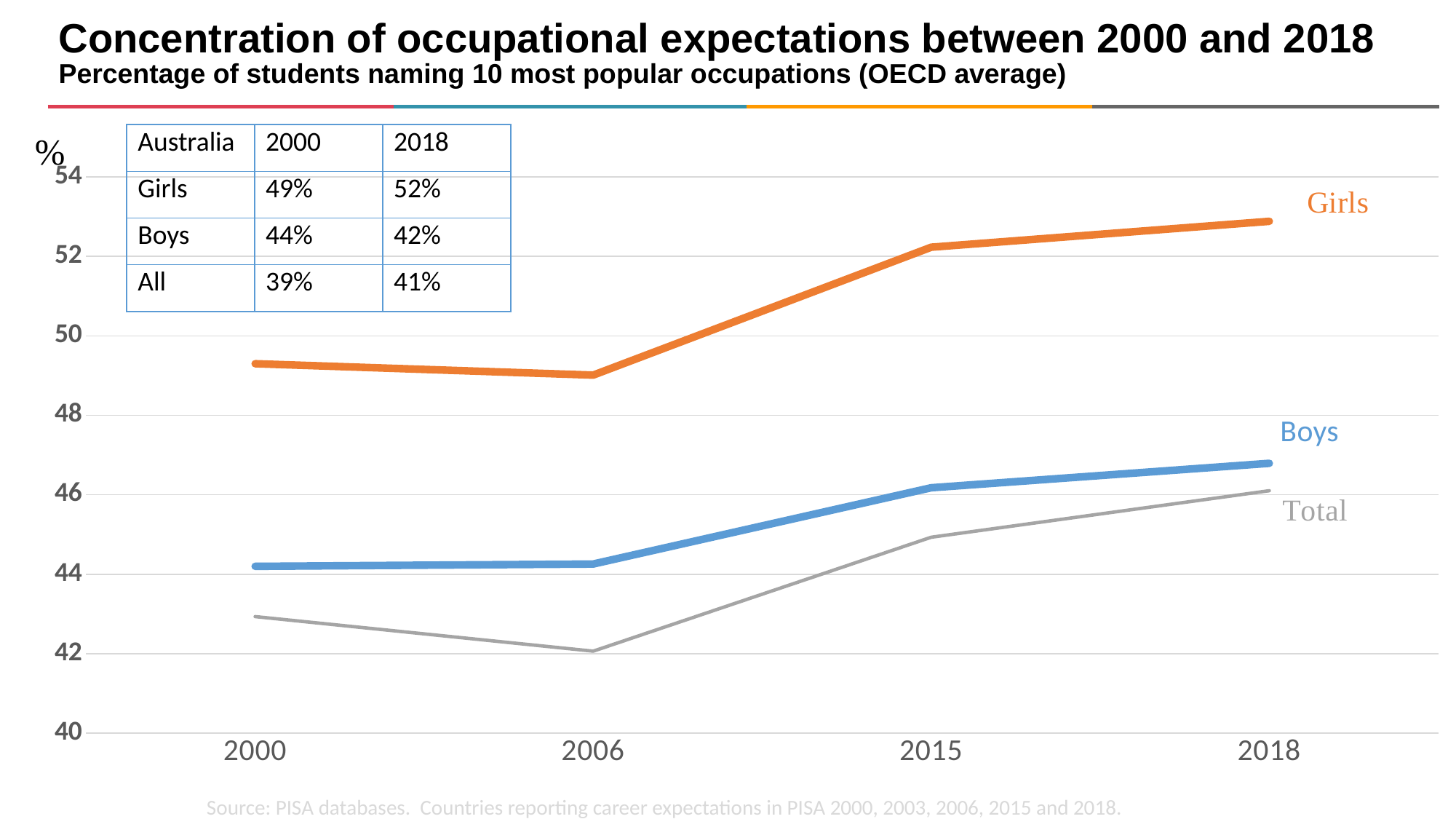
How many years are shown along the x axis of the chart? 4 Is the value for Boys in 2018 greater or less than 46? greater Which series has the highest values across the chart? Girls Is the value for Girls in 2018 greater or less than 52? greater How many series are plotted on the chart? 3 Is the value for Girls in 2000 greater or less than 50? less In which year is the Total series at its lowest? 2006 In 2018, which is larger, the value for Girls or the value for Boys? Girls What kind of chart is shown on the slide? line chart Does the Girls series rise or fall between 2006 and 2018? rise What is the title of the chart? Concentration of occupational expectations between 2000 and 2018